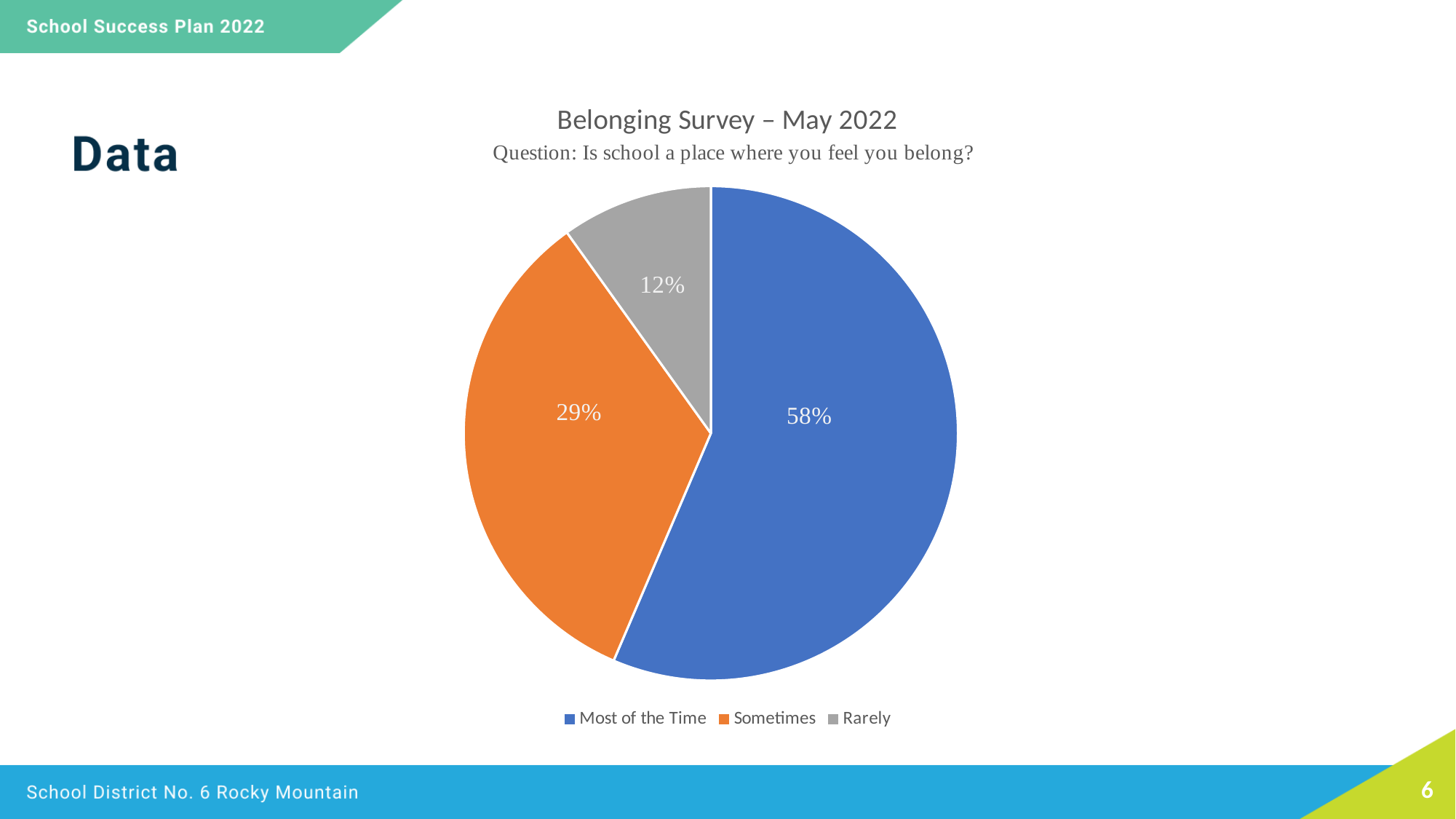
Which response category has the largest share of the pie? Most of the Time What kind of chart is shown on the slide? Pie chart What percentage of respondents answered "Sometimes"? 29% What is the difference in percentage points between "Sometimes" and "Rarely"? 17 Which response category has the smallest share of the pie? Rarely Which is larger, the share for "Sometimes" or the share for "Rarely"? Sometimes What is the difference in percentage points between "Most of the Time" and "Sometimes"? 29 What percentage of respondents answered "Most of the Time"? 58% What is the title of the chart? Belonging Survey – May 2022 What percentage of respondents answered "Rarely"? 12% What colour is the "Sometimes" slice? Orange How many response categories does the pie chart show? 3